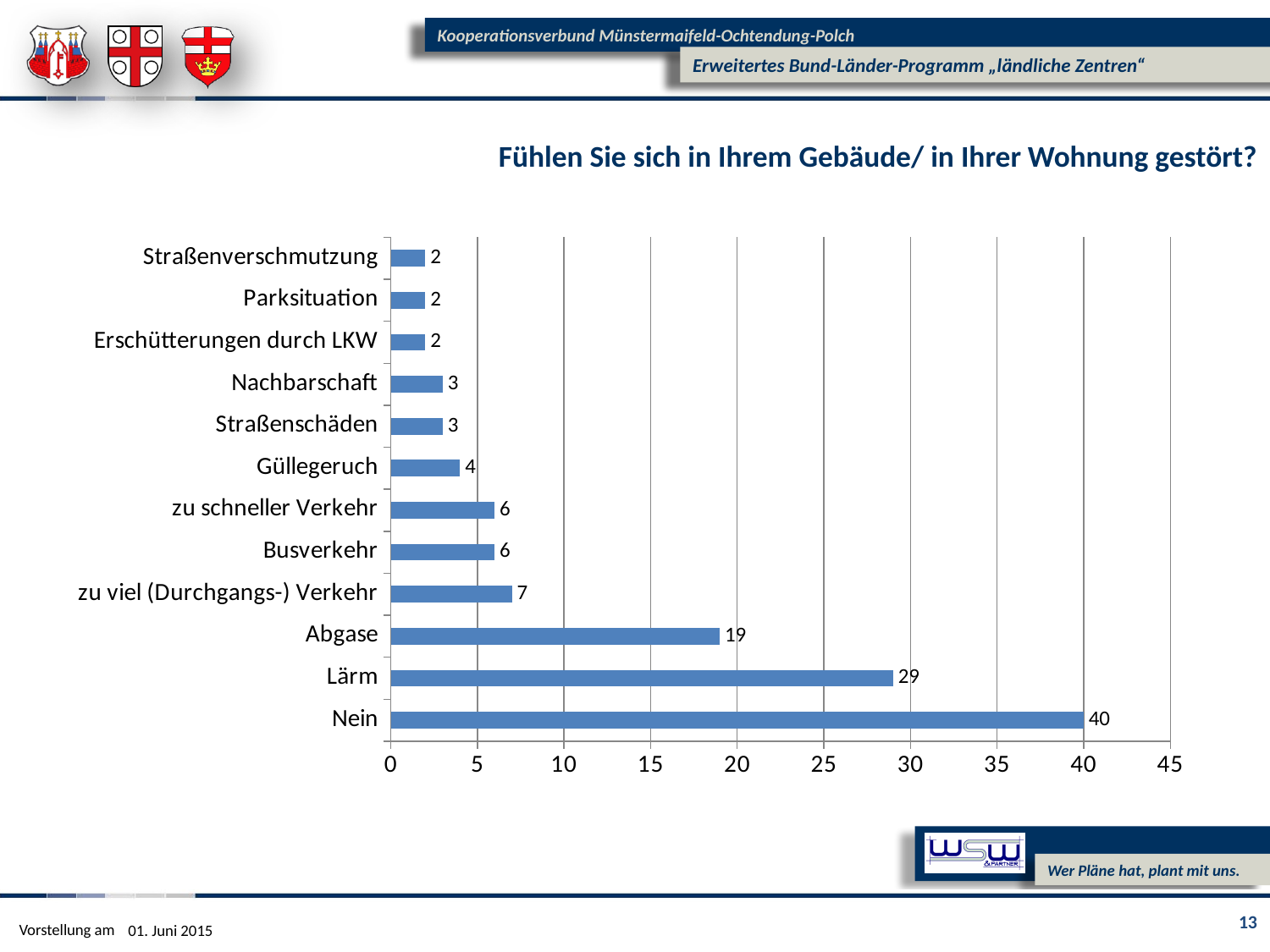
How many categories are shown in the chart? 12 What is the difference between the values for Lärm and Abgase? 10 What kind of chart is shown on the slide? bar chart Which category has the highest value? Nein What is the value for Abgase? 19 Is the value for Lärm greater or less than 25? greater What is the value for Nein? 40 Which is larger, the value for Abgase or the value for zu viel (Durchgangs-) Verkehr? Abgase What is the value for Güllegeruch? 4 What is the difference between the values for Nein and Lärm? 11 What is the value for Lärm? 29 What is the title of the chart? Fühlen Sie sich in Ihrem Gebäude/ in Ihrer Wohnung gestört?